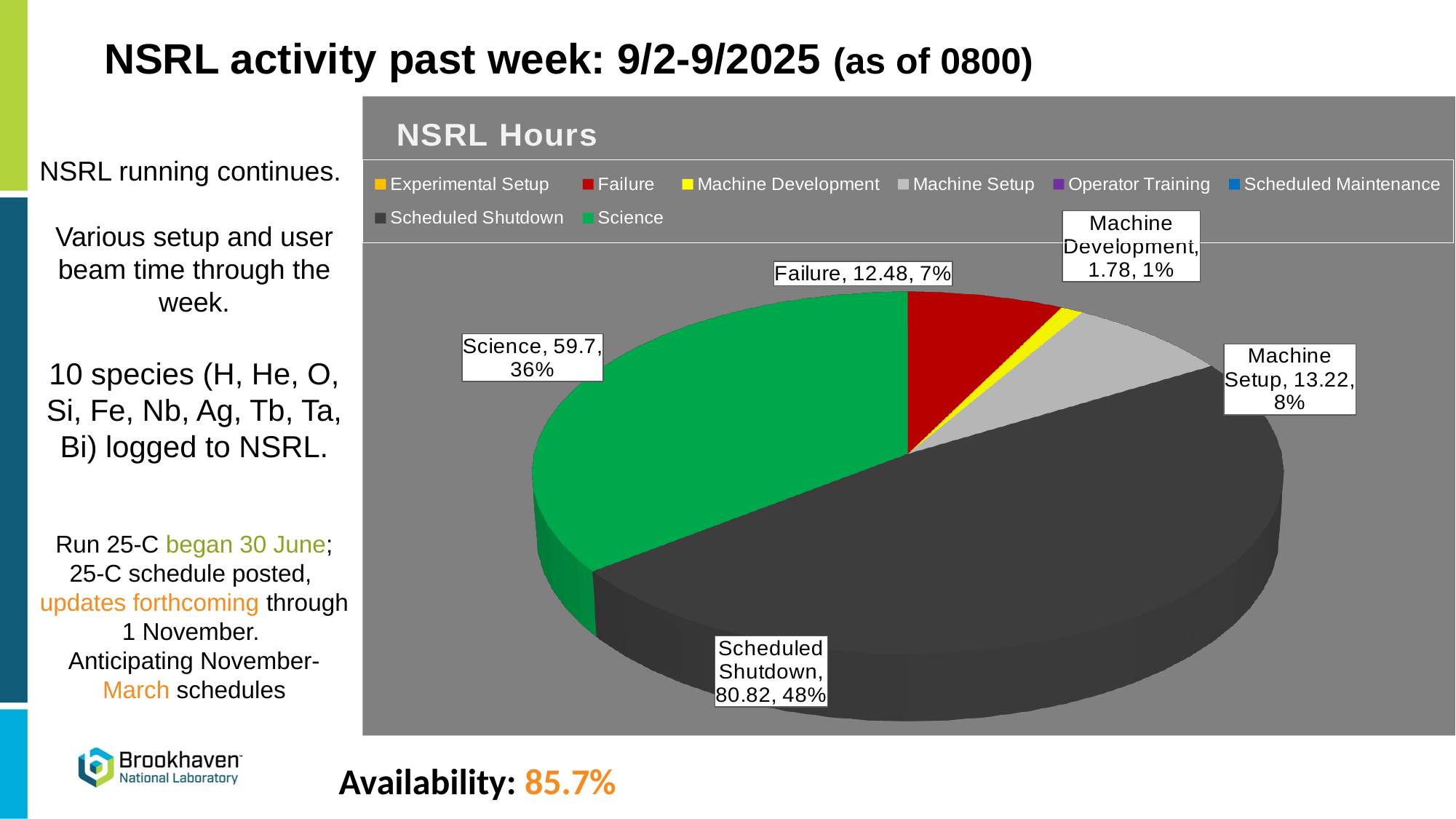
What share of the pie does Science represent? 36% How many hours are shown for Scheduled Shutdown? 80.82 What is the title of the chart? NSRL Hours Which labeled category has the smallest slice of the pie? Machine Development How many hours are shown for Machine Setup? 13.22 How many hours are shown for Failure? 12.48 What type of chart is shown on the slide? pie chart What share of the pie does Machine Development represent? 1% How many hours are shown for Science? 59.7 What is the difference in hours between Scheduled Shutdown and Science? 21.12 How many entries does the chart legend list? 8 Which category has the largest slice of the pie? Scheduled Shutdown